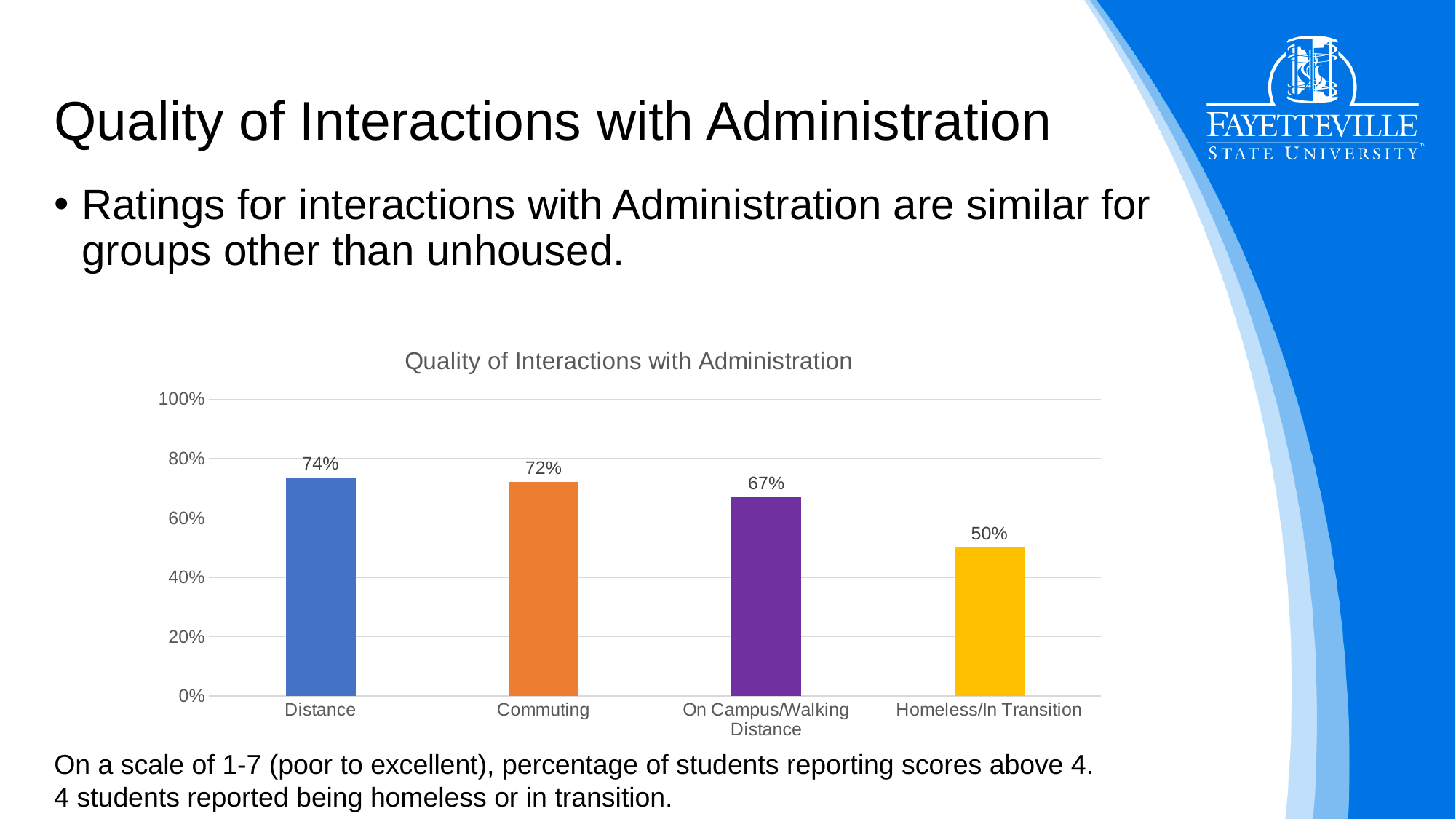
What is the value for On Campus/Walking Distance? 67% What kind of chart is shown on the slide? Bar chart What is the title of the chart? Quality of Interactions with Administration What is the value for Homeless/In Transition? 50% What is the value for Commuting? 72% Which category has the lowest value? Homeless/In Transition What is the difference between the values for Distance and Homeless/In Transition? 24% Which category has the highest value? Distance How many categories are shown in the chart? 4 What is the value for Distance? 74% Which is larger, the value for On Campus/Walking Distance or the value for Homeless/In Transition? On Campus/Walking Distance What is the difference between the values for Commuting and On Campus/Walking Distance? 5%